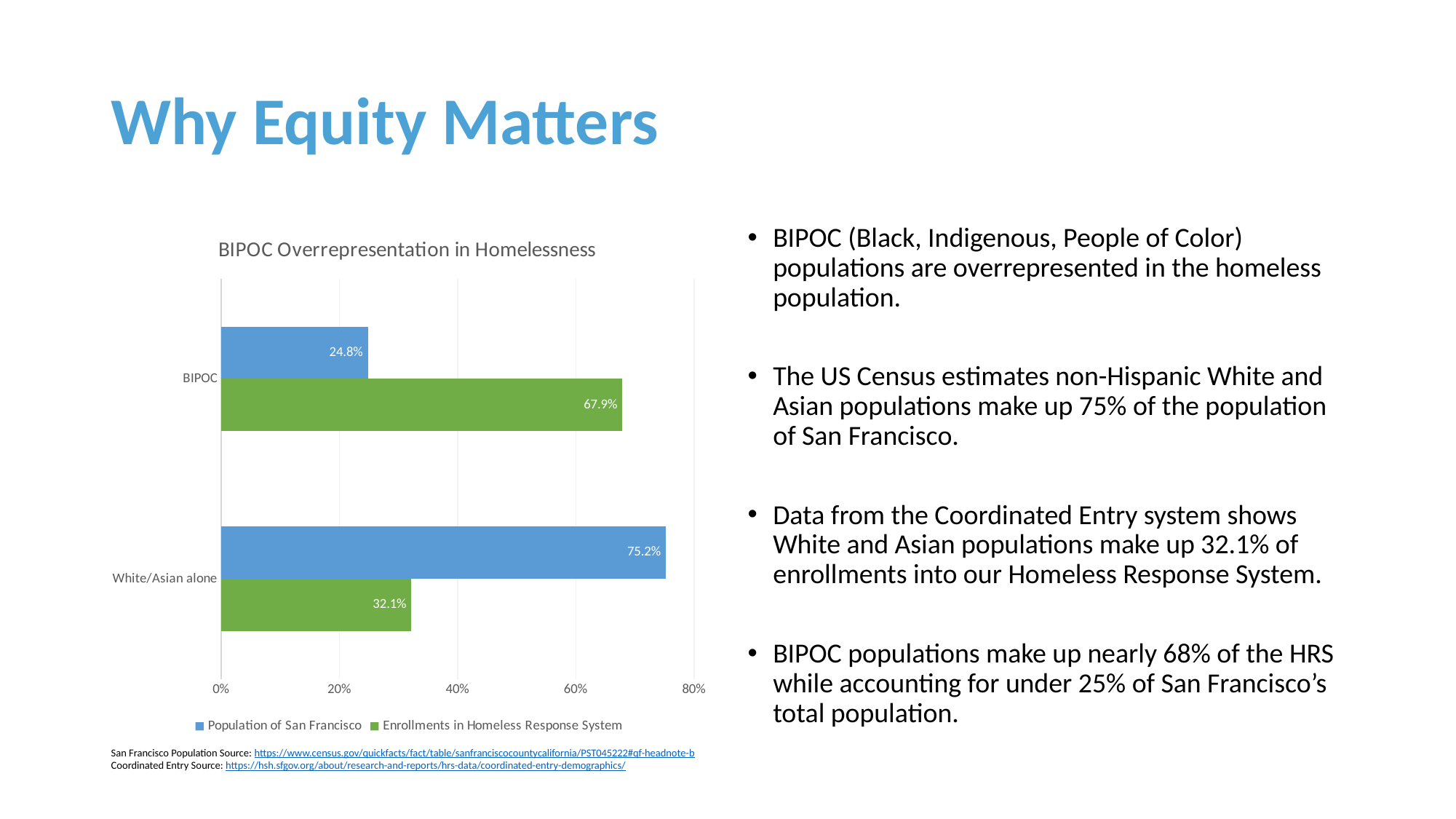
What is the Enrollments in Homeless Response System value for White/Asian alone? 32.1% How many categories are shown on the chart? 2 For White/Asian alone, which is larger: Population of San Francisco or Enrollments in Homeless Response System? Population of San Francisco Is the Population of San Francisco value for White/Asian alone greater or less than 60%? greater Which category has the higher Enrollments in Homeless Response System value? BIPOC What is the Population of San Francisco value for White/Asian alone? 75.2% What is the Population of San Francisco value for BIPOC? 24.8% Which category has the lower Population of San Francisco value? BIPOC What is the Enrollments in Homeless Response System value for BIPOC? 67.9% What is the difference between the Enrollments in Homeless Response System value and the Population of San Francisco value for BIPOC? 43.1% How many series does the legend list? 2 What kind of chart is shown on the slide? Bar chart